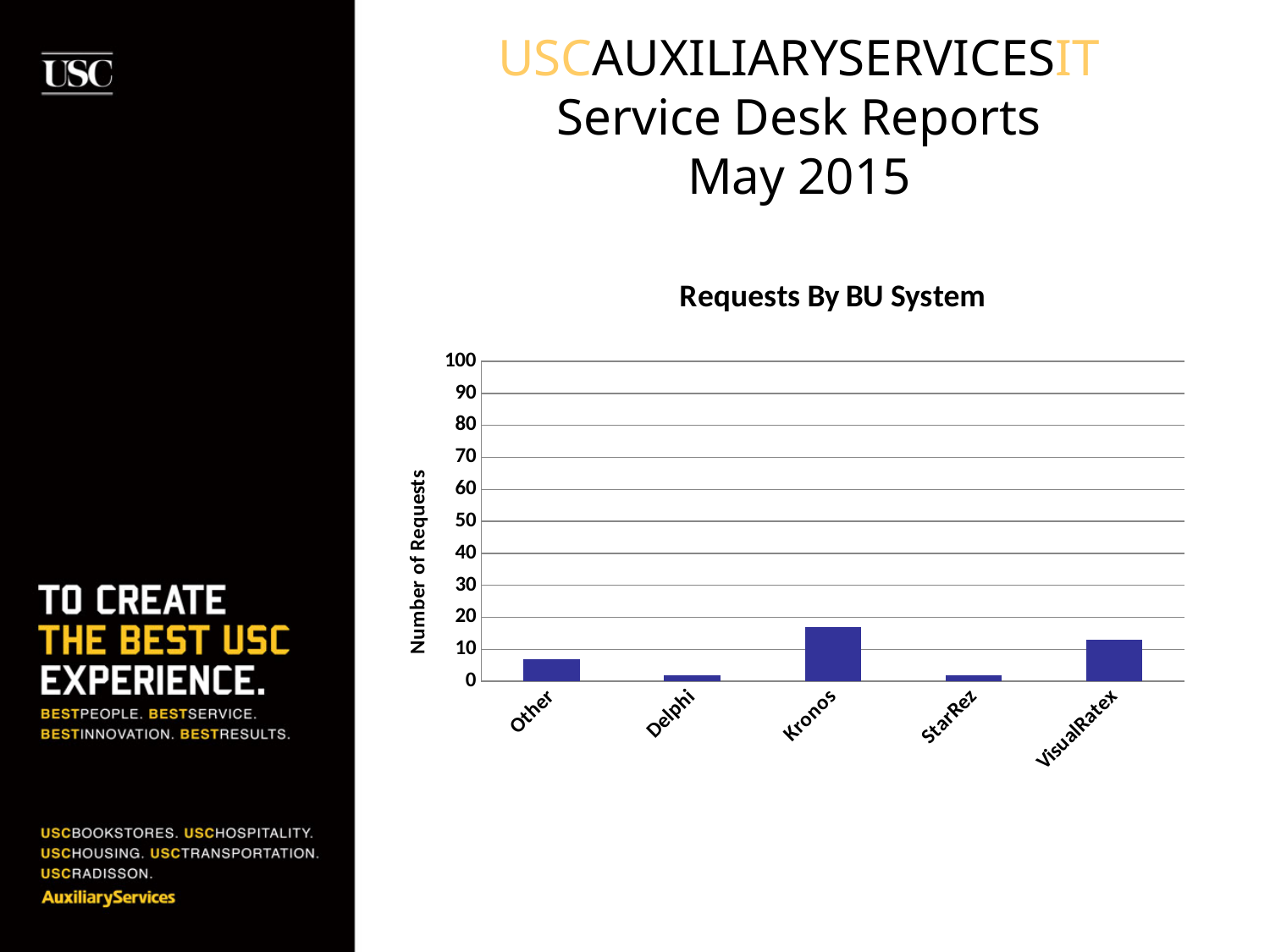
What is the label on the vertical axis of the chart? Number of Requests Which has more requests, Kronos or VisualRatex? Kronos Is the number of requests for Delphi greater or less than 10? less What is the title of the chart? Requests By BU System Is the number of requests for Other greater or less than 10? less Which BU system has the highest number of requests? Kronos Is the number of requests for Kronos greater or less than 10? greater Which has more requests, Other or Kronos? Kronos What kind of chart is shown on the slide? bar chart How many BU systems (categories) are shown on the x axis of the chart? 5